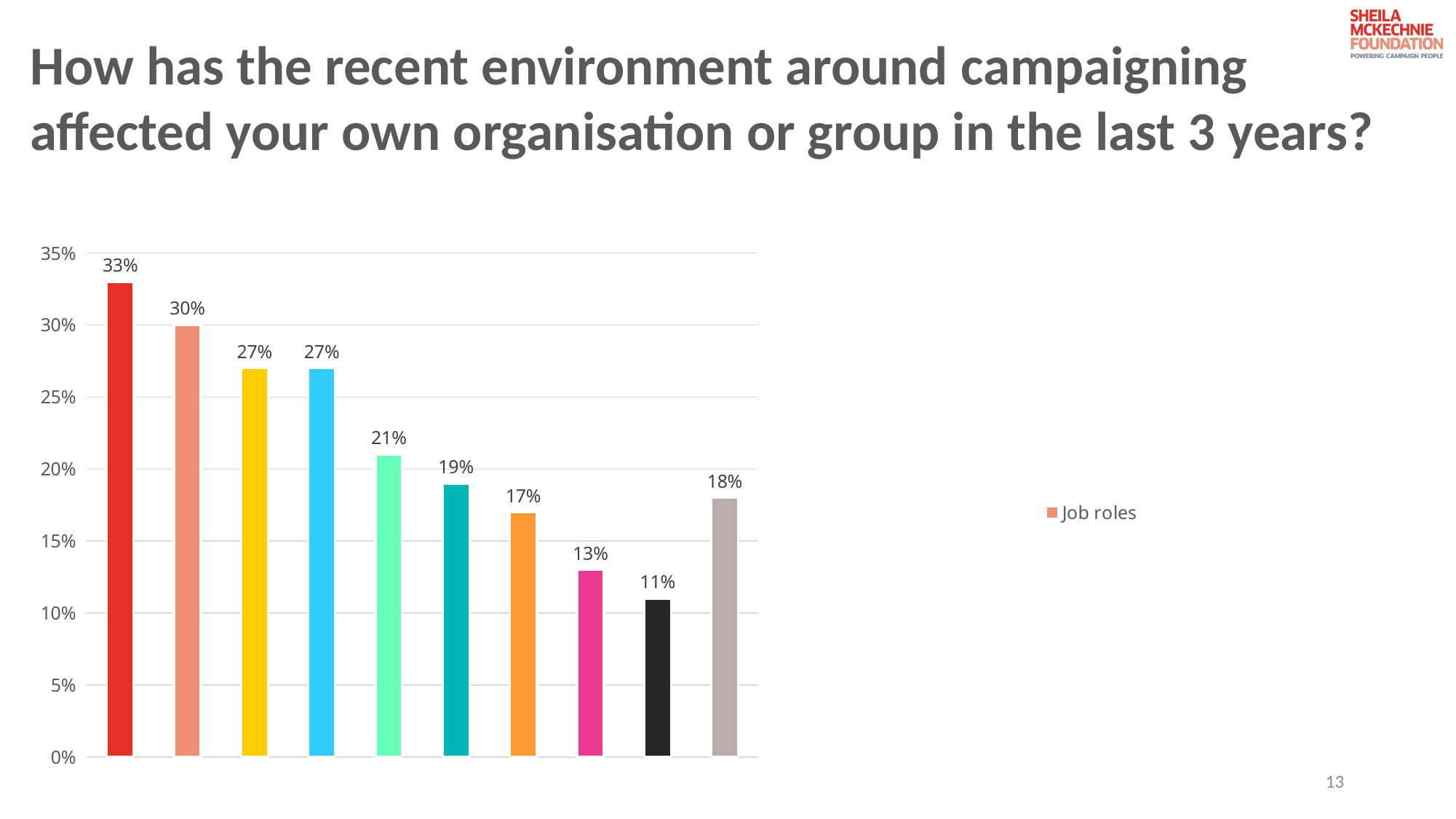
What is the name of the series shown in the legend? Job roles How many bars are plotted in the chart? 10 What is the lowest value shown in the chart? 11% How many series does the legend list? 1 What is the value of the first (red) bar from the left? 33% Which is larger, the value of the pink bar or the value of the grey bar on the far right? the grey bar (18%) What is the value of the black bar? 11% What is the value of the last (grey) bar on the right? 18% What type of chart is shown on the slide? bar chart What is the value of the light green bar? 21% What is the difference between the first bar (33%) and the second bar (30%)? 3% What is the highest value shown in the chart? 33%